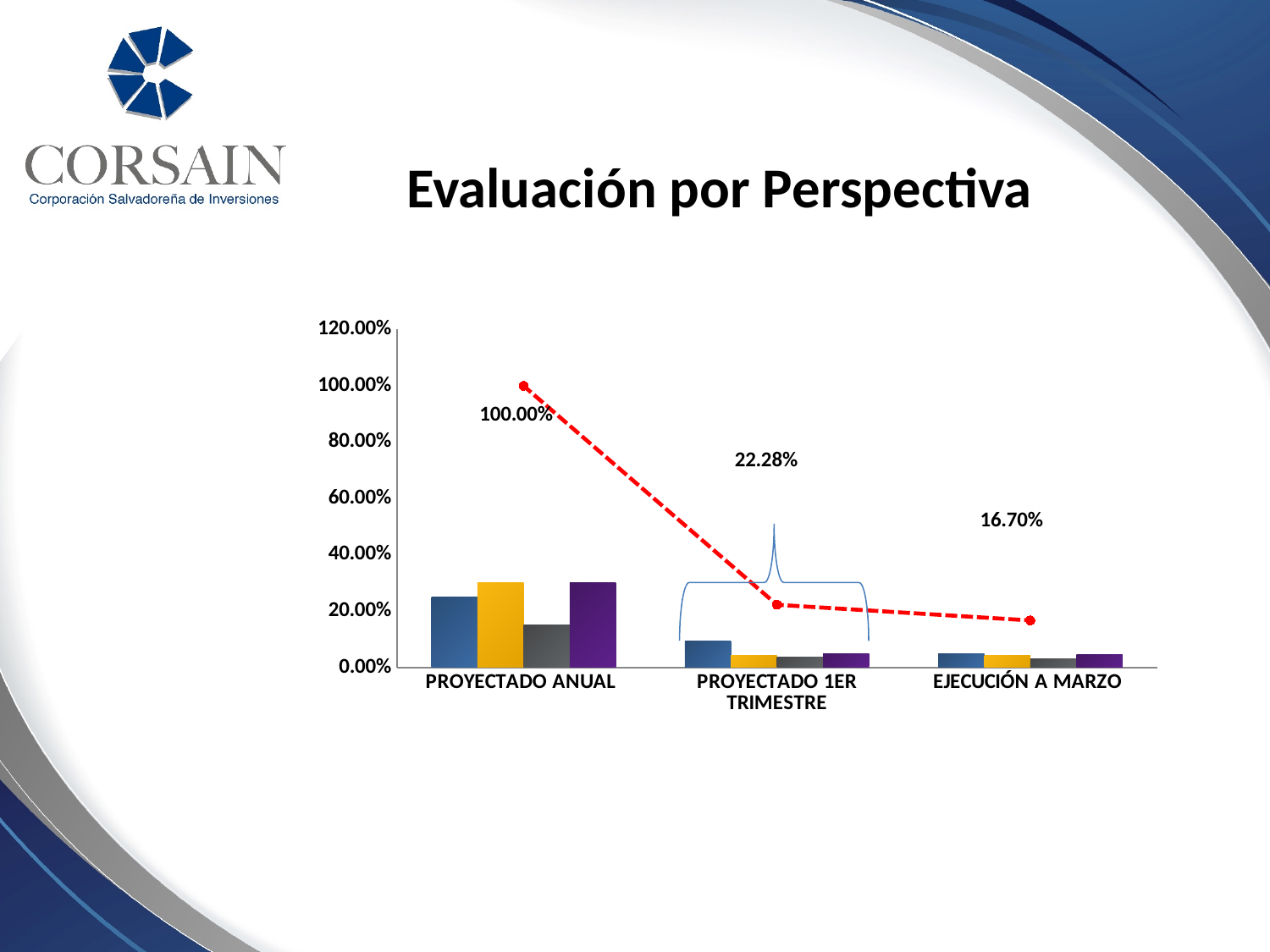
Does the red dashed line rise or fall from left to right across the categories? fall At which category does the red dashed line reach its lowest value? EJECUCIÓN A MARZO Is the yellow bar for PROYECTADO ANUAL greater or less than 20.00%? greater What is the value of the red dashed line at PROYECTADO ANUAL? 100.00% What is the difference between the line values at PROYECTADO ANUAL and PROYECTADO 1ER TRIMESTRE? 77.72% At which category does the red dashed line reach its highest value? PROYECTADO ANUAL Which is larger: the line value at PROYECTADO 1ER TRIMESTRE or at EJECUCIÓN A MARZO? PROYECTADO 1ER TRIMESTRE What is the difference between the line values at PROYECTADO 1ER TRIMESTRE and EJECUCIÓN A MARZO? 5.58% What is the value of the red dashed line at EJECUCIÓN A MARZO? 16.70% What is the title of the slide containing the chart? Evaluación por Perspectiva What is the value of the red dashed line at PROYECTADO 1ER TRIMESTRE? 22.28% How many categories are shown on the x axis? 3